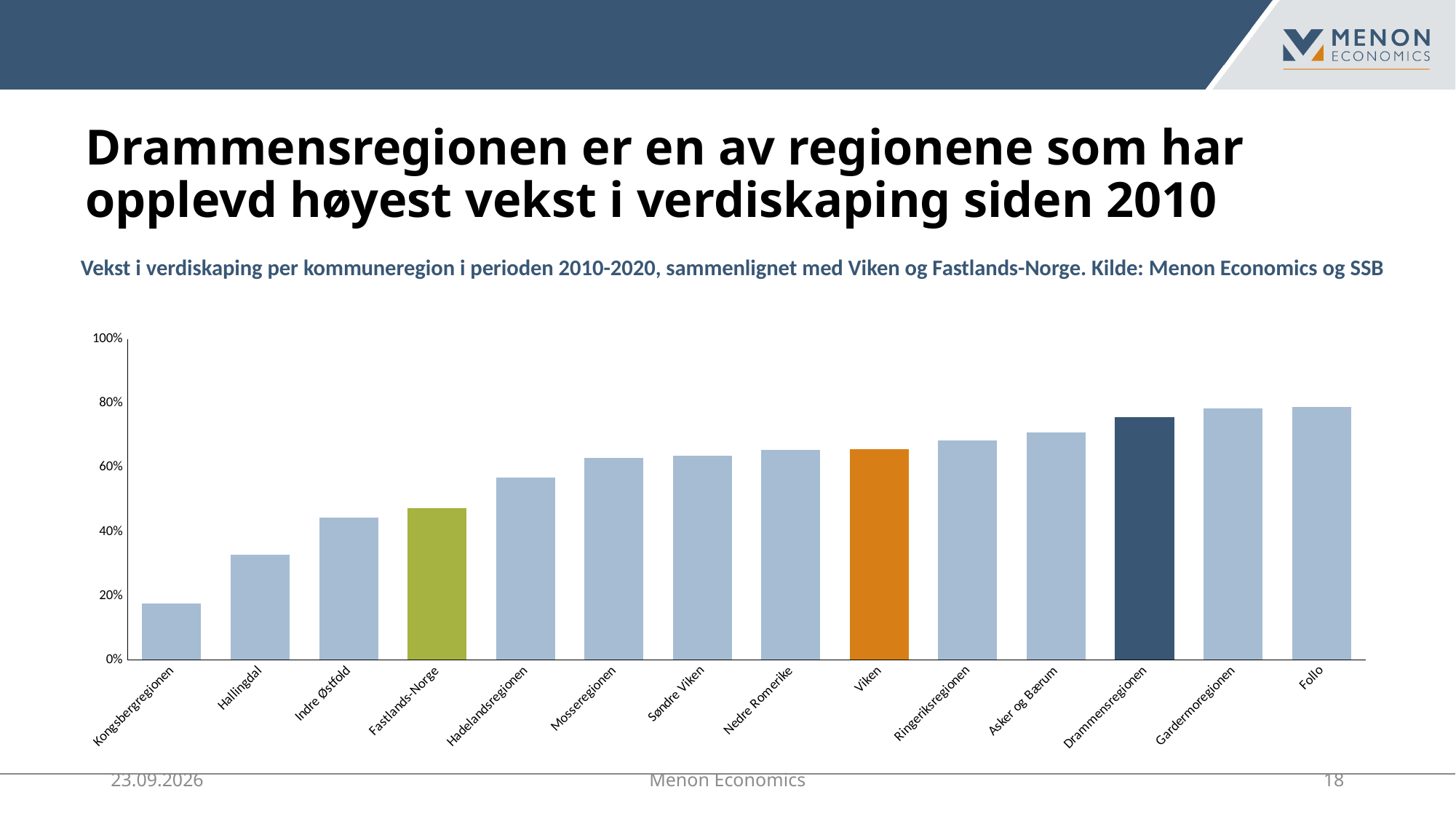
How many regions (bars) are shown in the chart? 14 Is the value for Fastlands-Norge greater or less than 40%? greater Which region's bar is coloured orange? Viken Which is larger, the value for Drammensregionen or the value for Viken? Drammensregionen Do the bar values rise or fall from left to right along the x axis? rise Is the value for Hallingdal greater or less than 40%? less What kind of chart is shown on the slide? bar chart Which region has the lowest growth in value creation in the chart? Kongsbergregionen Is the value for Kongsbergregionen greater or less than 20%? less Which is larger, the value for Hallingdal or the value for Indre Østfold? Indre Østfold